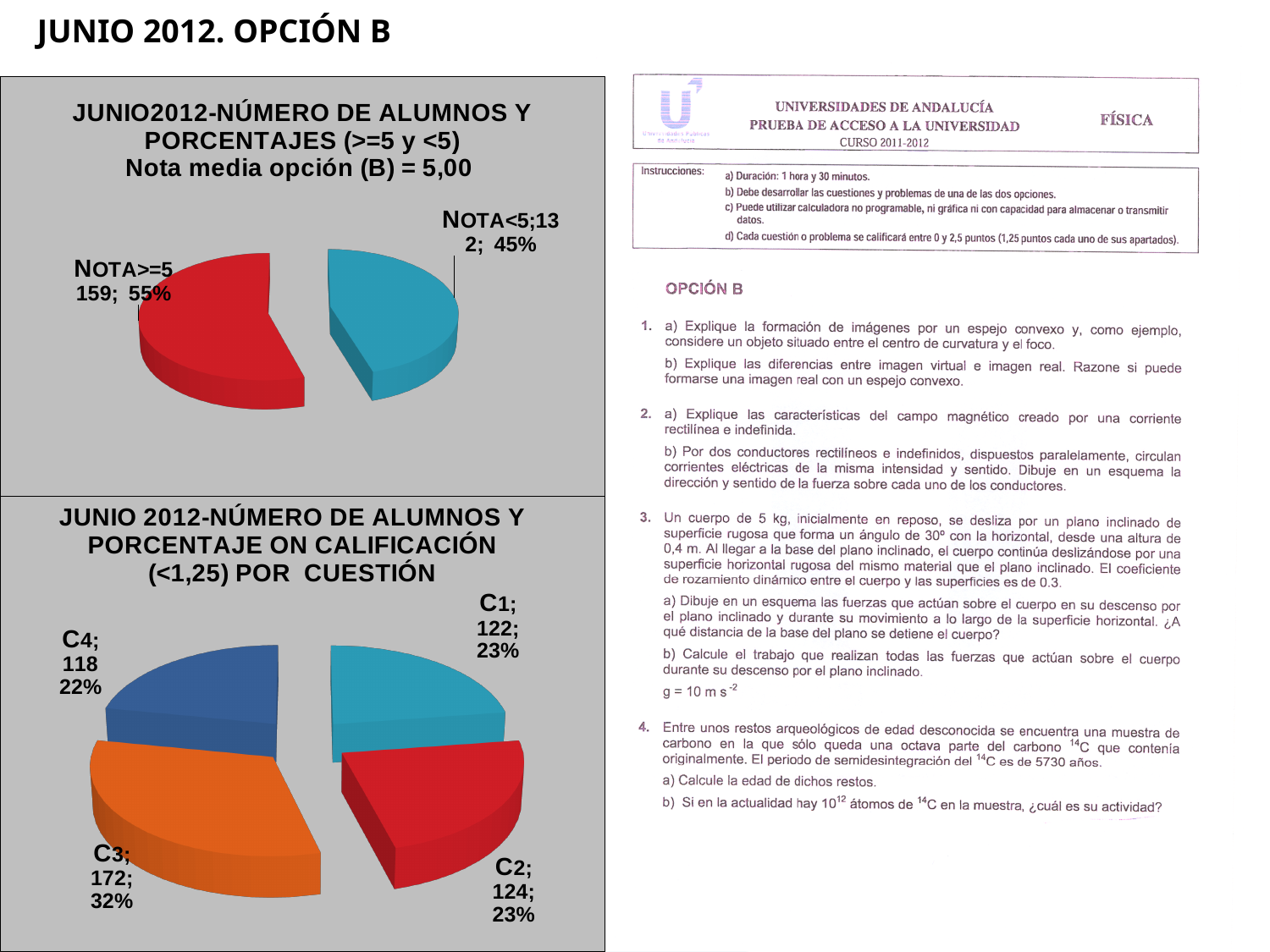
In the bottom pie chart (POR CUESTIÓN), what percentage share does C3 have? 32% What kind of chart is the top chart on the left (JUNIO2012-NÚMERO DE ALUMNOS Y PORCENTAJES)? Pie chart In the top pie chart, how many students are in the NOTA<5 category? 132 In the top pie chart, what is the nota media for opción B stated in the title? 5,00 In the bottom pie chart (POR CUESTIÓN), how many slices are there? 4 In the top pie chart, how many students are in the NOTA>=5 category? 159 In the bottom pie chart (POR CUESTIÓN), which cuestión has the highest number of students? C3 In the bottom pie chart (POR CUESTIÓN), what is the difference between the values for C3 and C4? 54 In the top pie chart, what is the difference in number of students between NOTA>=5 and NOTA<5? 27 In the bottom pie chart (POR CUESTIÓN), what is the value for C2? 124 In the bottom pie chart (POR CUESTIÓN), which cuestión has the lowest number of students? C4 In the top pie chart, what percentage share does NOTA<5 have? 45%